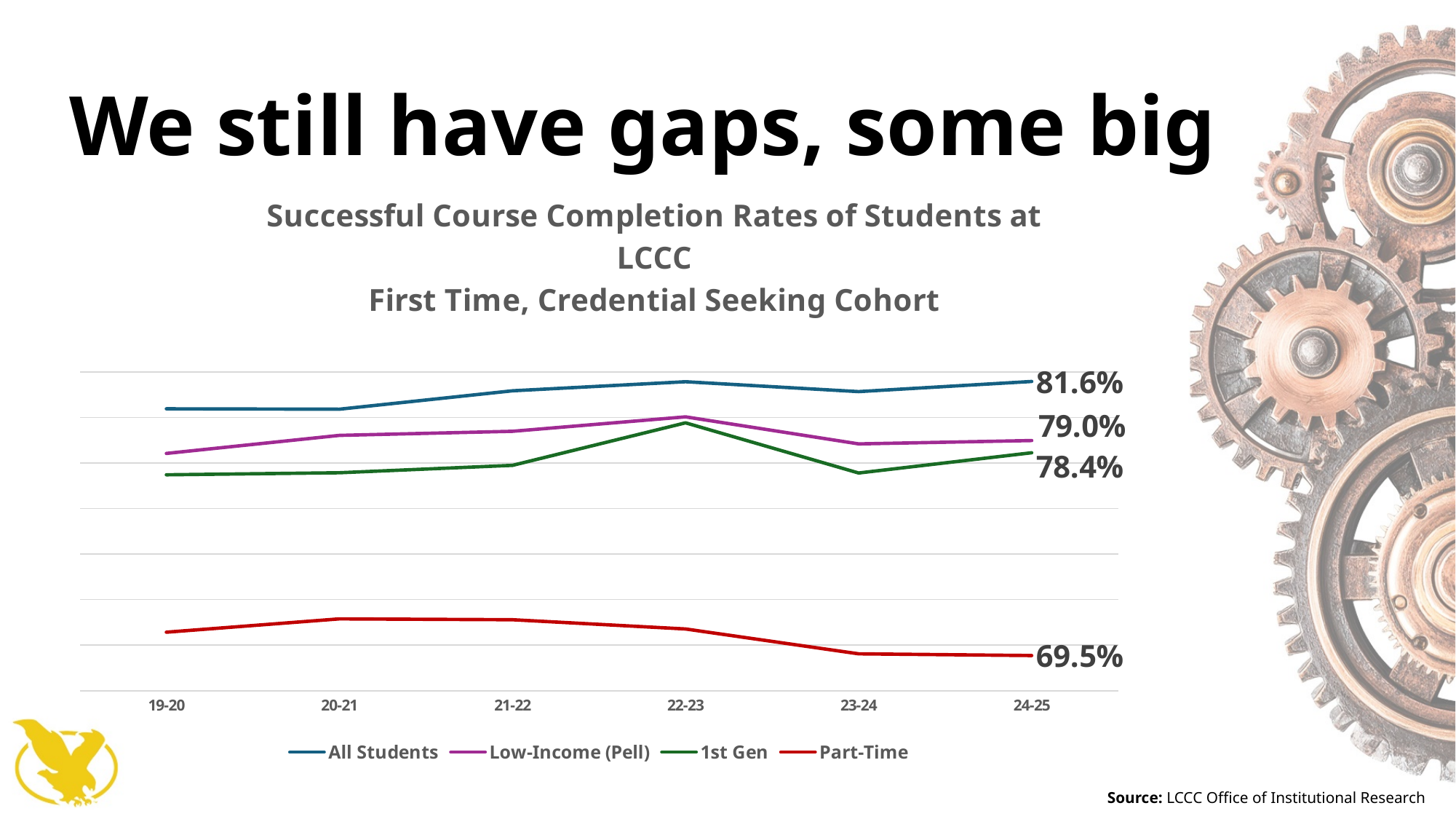
How many academic years are shown on the x axis? 6 What is the successful course completion rate for Low-Income (Pell) students in 24-25? 79.0% How many series does the legend list? 4 What is the successful course completion rate for 1st Gen students in 24-25? 78.4% What is the successful course completion rate for Part-Time students in 24-25? 69.5% What type of chart is shown on the slide? line chart Which group has the highest completion rate in 24-25? All Students What is the difference between the All Students and Part-Time completion rates in 24-25? 12.1% Does the Part-Time completion rate rise or fall from 22-23 to 23-24? fall Which is larger in 24-25, the Low-Income (Pell) rate or the 1st Gen rate? Low-Income (Pell) Which group has the lowest completion rate in 24-25? Part-Time What is the successful course completion rate for All Students in 24-25? 81.6%